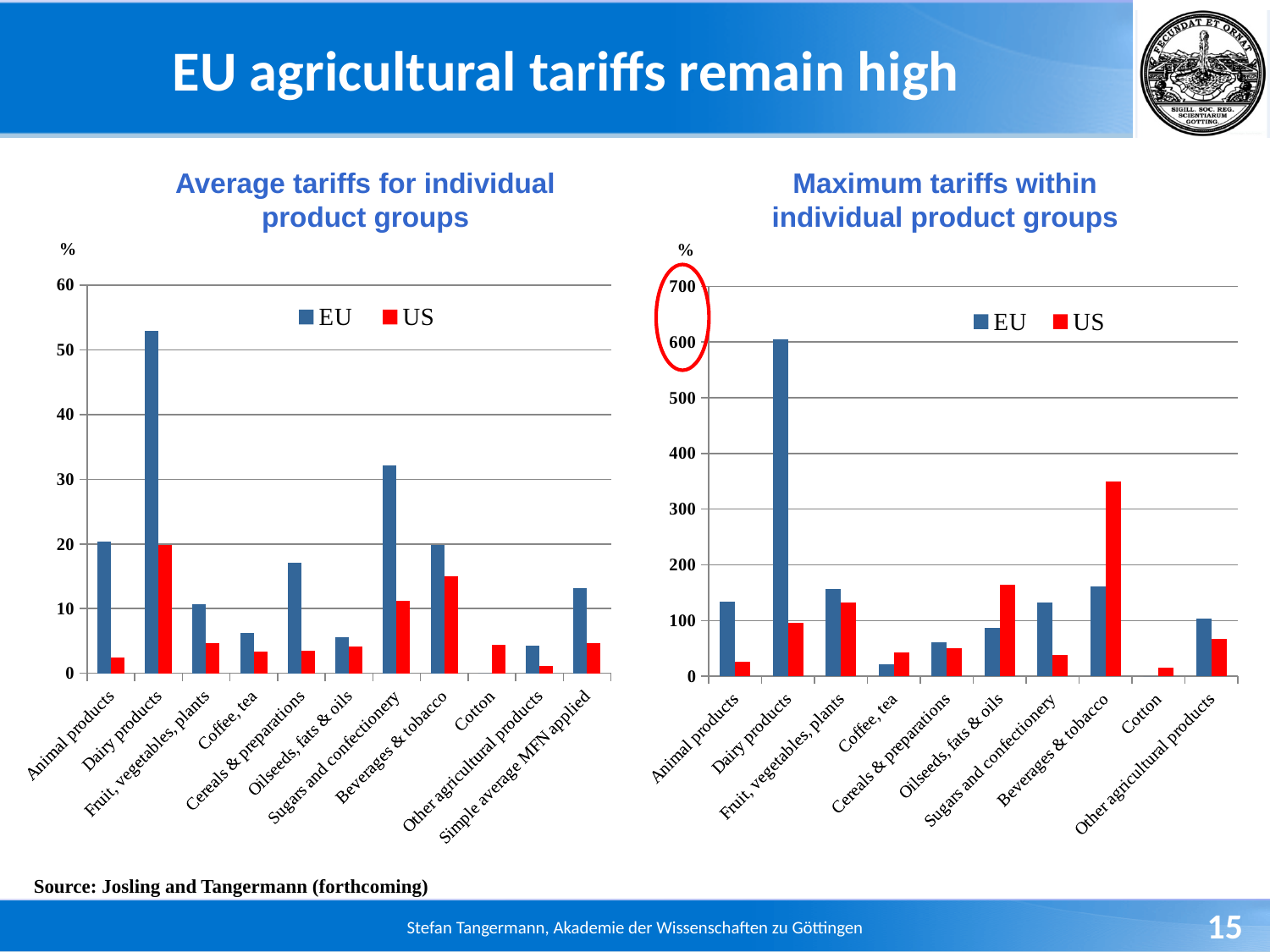
In the 'Maximum tariffs within individual product groups' chart, which product group has the highest US value? Beverages & tobacco In the 'Average tariffs for individual product groups' chart, is the EU value for Sugars and confectionery greater or less than 30? greater In the 'Average tariffs for individual product groups' chart, which product group has the highest EU value? Dairy products In the 'Average tariffs for individual product groups' chart, is the EU value for Dairy products greater or less than 50? greater In the 'Maximum tariffs within individual product groups' chart, is the US value for Beverages & tobacco greater or less than 300? greater In the 'Maximum tariffs within individual product groups' chart, which is larger for Sugars and confectionery, the EU value or the US value? EU How many series does the legend of the 'Average tariffs for individual product groups' chart list? 2 What kind of chart is the 'Average tariffs for individual product groups' chart? Bar chart How many product groups are shown on the x axis of the 'Maximum tariffs within individual product groups' chart? 10 In the 'Average tariffs for individual product groups' chart, which is larger for Cereals & preparations, the EU value or the US value? EU In the 'Maximum tariffs within individual product groups' chart, which product group has the highest EU value? Dairy products